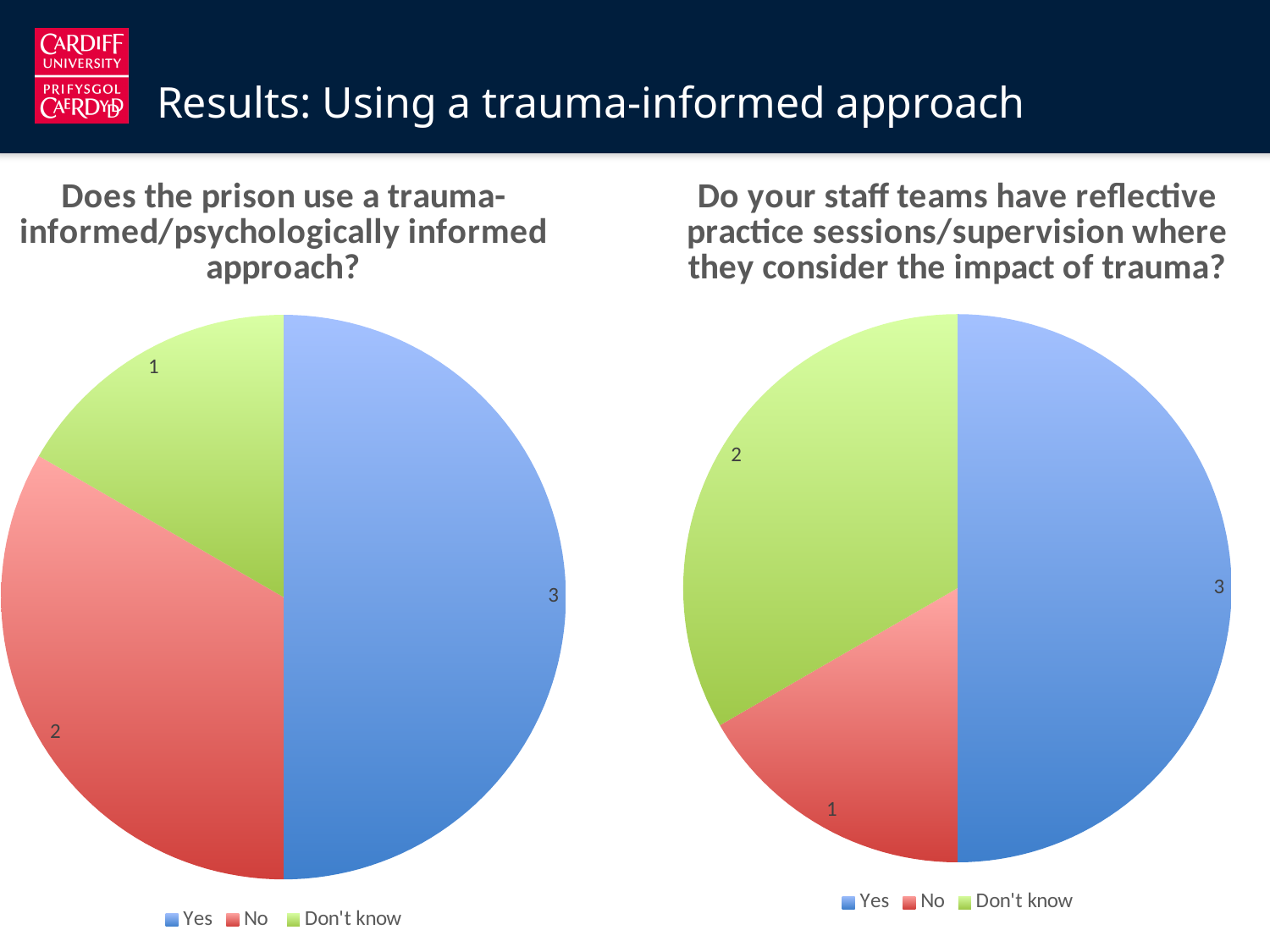
In the right pie chart, which category has the smallest slice? No In the left pie chart ("Does the prison use a trauma-informed/psychologically informed approach?"), what is the value for Don't know? 1 In the right pie chart, what share of the total does the Yes slice represent? 50% In the right pie chart, which is larger, the value for No or the value for Don't know? Don't know In the left pie chart ("Does the prison use a trauma-informed/psychologically informed approach?"), what is the value for No? 2 In the left pie chart ("Does the prison use a trauma-informed/psychologically informed approach?"), what is the value for Yes? 3 How many slices does the right pie chart have? 3 What type of chart is used on the left of the slide? Pie chart In the right pie chart ("Do your staff teams have reflective practice sessions/supervision where they consider the impact of trauma?"), what is the value for No? 1 In the left pie chart, which category has the largest slice? Yes In the left pie chart, what is the difference between the values for Yes and Don't know? 2 In the right pie chart ("Do your staff teams have reflective practice sessions/supervision where they consider the impact of trauma?"), what is the value for Don't know? 2